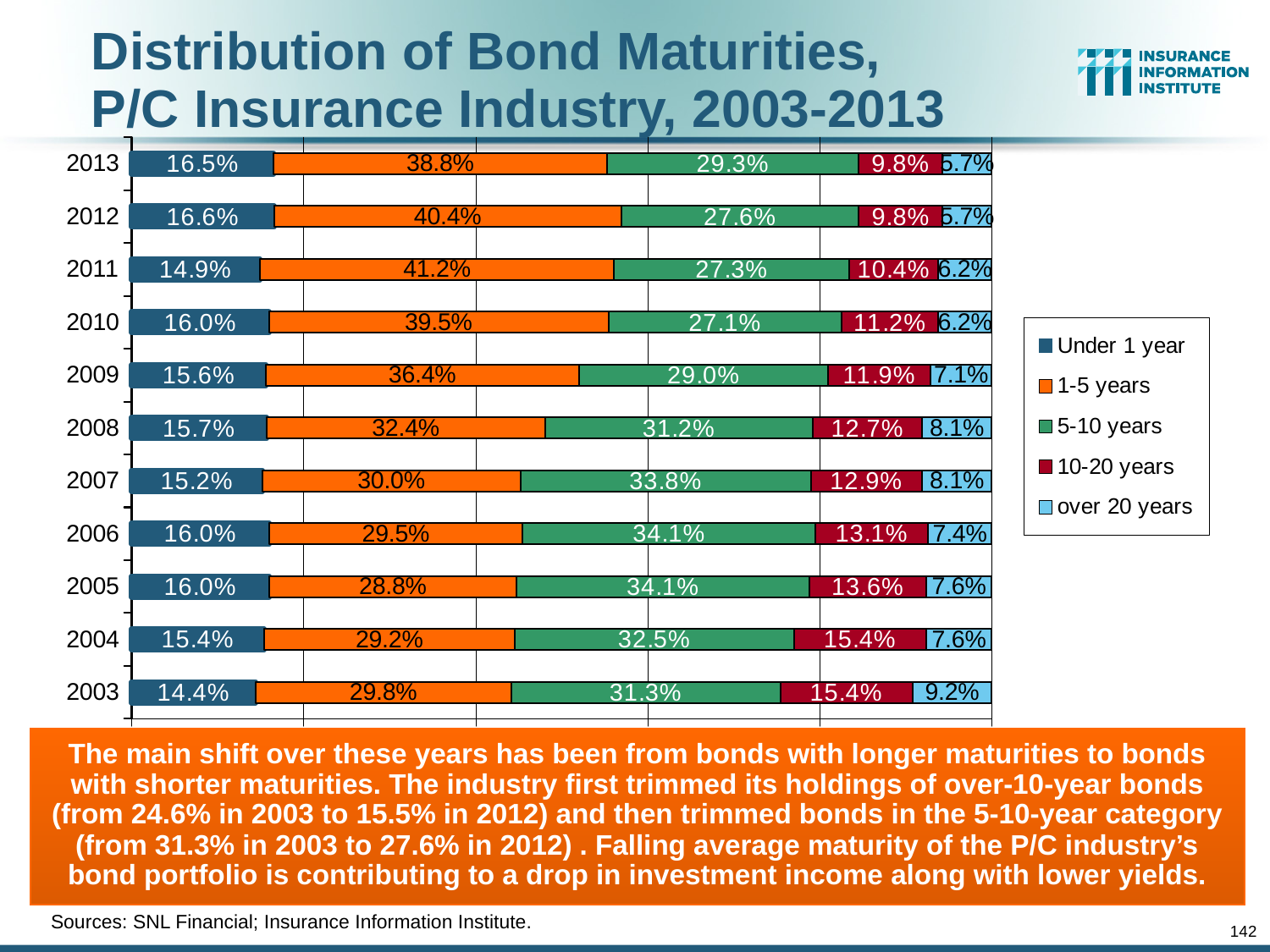
In which year was the 1-5 years share the highest? 2011 What was the 'over 20 years' share in 2003? 9.2% In which year was the 'over 20 years' share the highest? 2003 What type of chart is shown on the slide? Stacked bar chart How many years are shown on the chart? 11 By how many percentage points did the 1-5 years share in 2013 exceed that in 2003? 9.0 percentage points What share of bonds had maturities of 1-5 years in 2013? 38.8% How many maturity categories does the legend list? 5 In which year was the 'Under 1 year' share the lowest? 2003 What share of bonds had 5-10 year maturities in 2007? 33.8% In 2008, which was larger: the 1-5 years share or the 5-10 years share? 1-5 years What was the 'Under 1 year' share in 2011? 14.9%